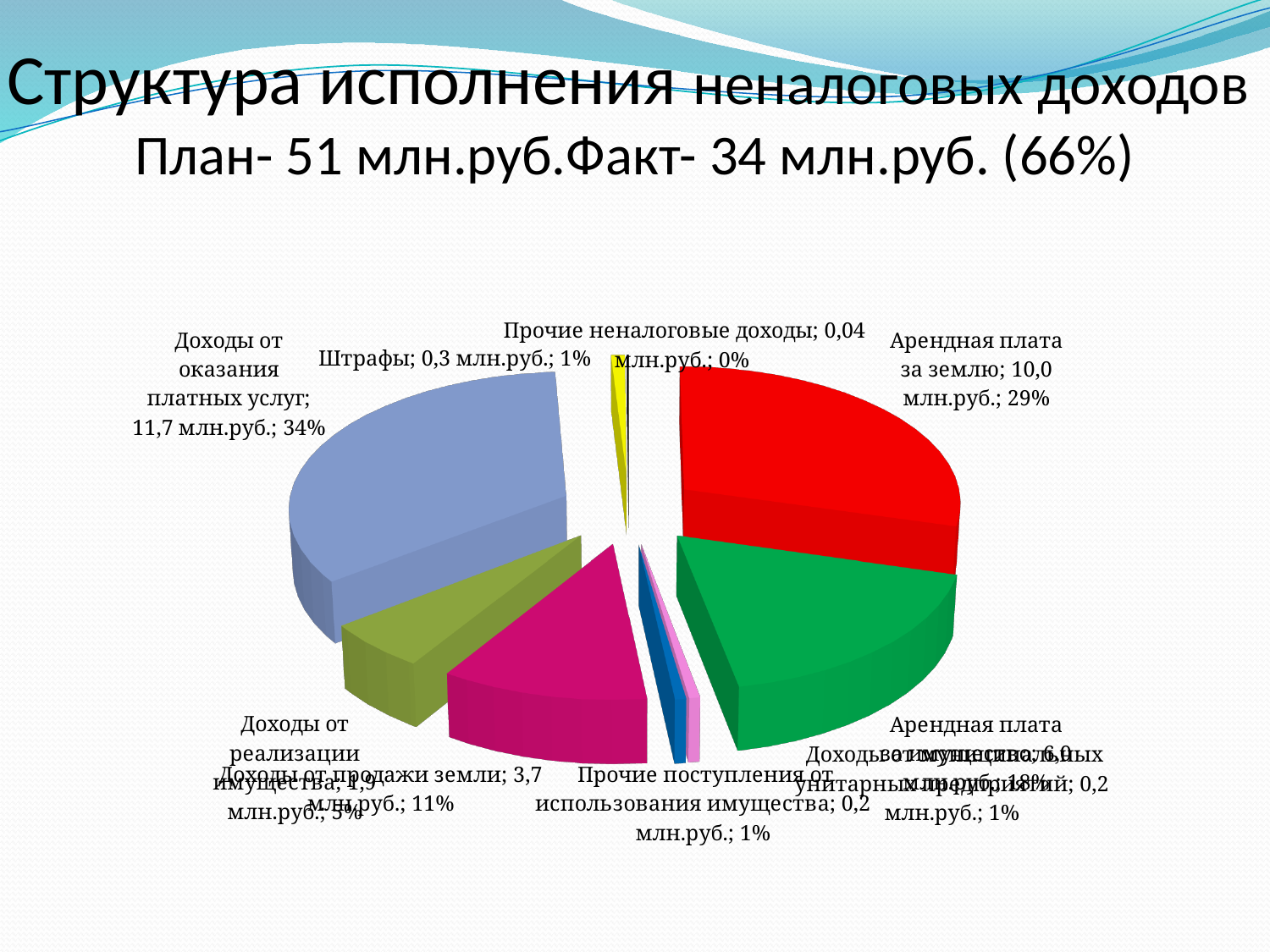
What is the value for Штрафы? 0,3 млн.руб. What kind of chart is shown on the slide? pie chart What is the value for Доходы от оказания платных услуг? 11,7 млн.руб. What is the difference between the values for Доходы от оказания платных услуг and Арендная плата за землю? 1,7 млн.руб. According to the slide title, what is the planned amount (План) of non-tax revenues? 51 млн.руб. Which category has the smallest slice of the pie? Прочие неналоговые доходы Which is larger: Арендная плата за землю or Доходы от продажи земли? Арендная плата за землю Which category has the largest slice of the pie? Доходы от оказания платных услуг What is the value for Доходы от продажи земли? 3,7 млн.руб. What share of the pie does Арендная плата за землю represent? 29% What share of the pie does Доходы от продажи земли represent? 11% What share of the pie does Прочие неналоговые доходы represent? 0%